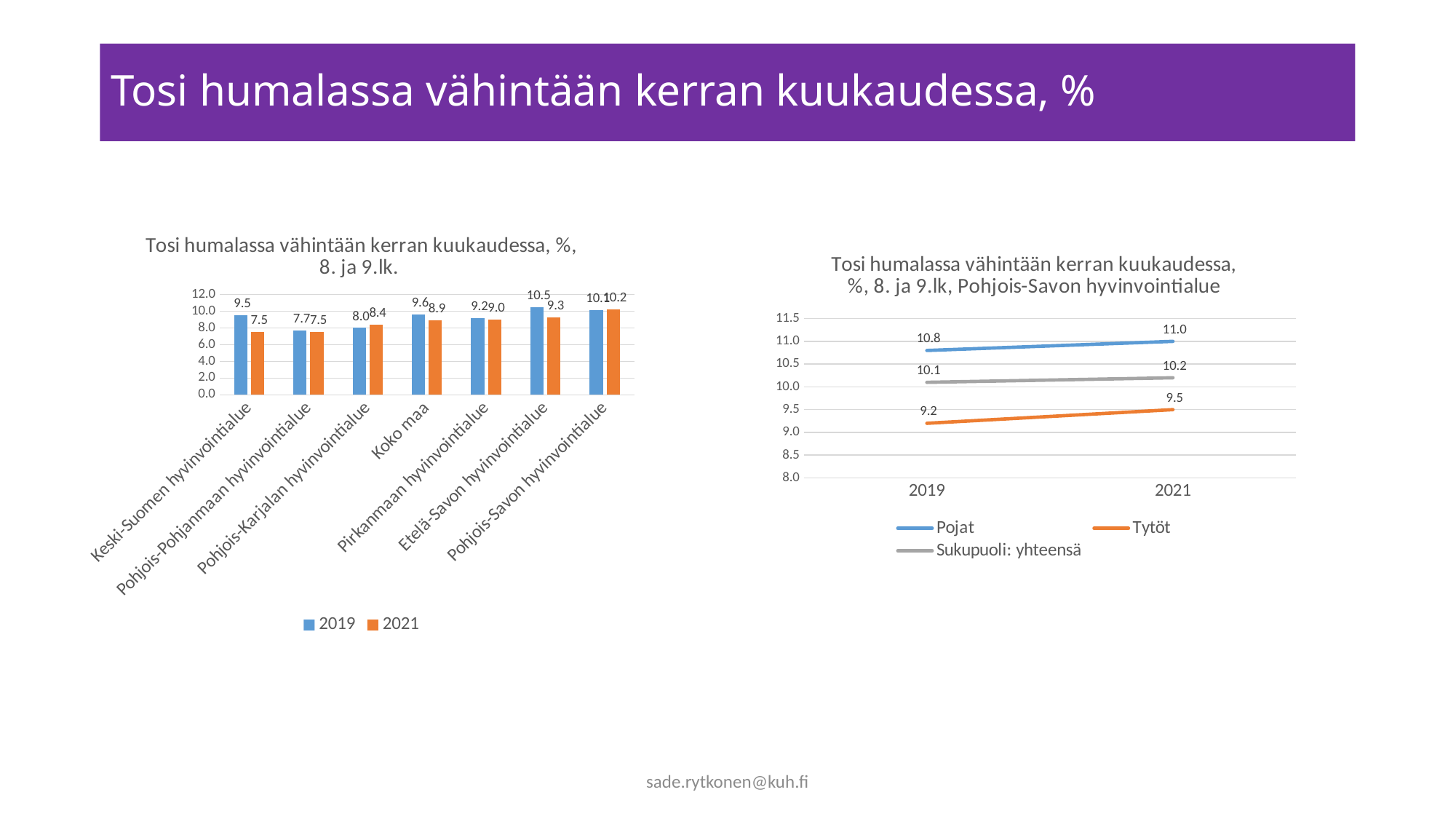
In the left bar chart, is the 2019 or the 2021 value larger for Koko maa? 2019 How many categories are shown on the x axis of the left bar chart? 7 In the left bar chart, what is the 2021 value for Pohjois-Karjalan hyvinvointialue? 8.4 In the left bar chart, what is the 2019 value for Keski-Suomen hyvinvointialue? 9.5 In the left bar chart, which category has the lowest 2019 value? Pohjois-Pohjanmaan hyvinvointialue How many series does the legend of the right line chart list? 3 In the right line chart, what is the difference between Pojat and Tytöt in 2021? 1.5 What kind of chart is the chart on the right of the slide (Pohjois-Savon hyvinvointialue)? line chart In the left bar chart, what is the difference between the 2019 and 2021 values for Etelä-Savon hyvinvointialue? 1.2 In the left bar chart, which category has the highest 2019 value? Etelä-Savon hyvinvointialue In the right line chart, what is the value for Tytöt in 2021? 9.5 What kind of chart is the chart on the left of the slide? bar chart